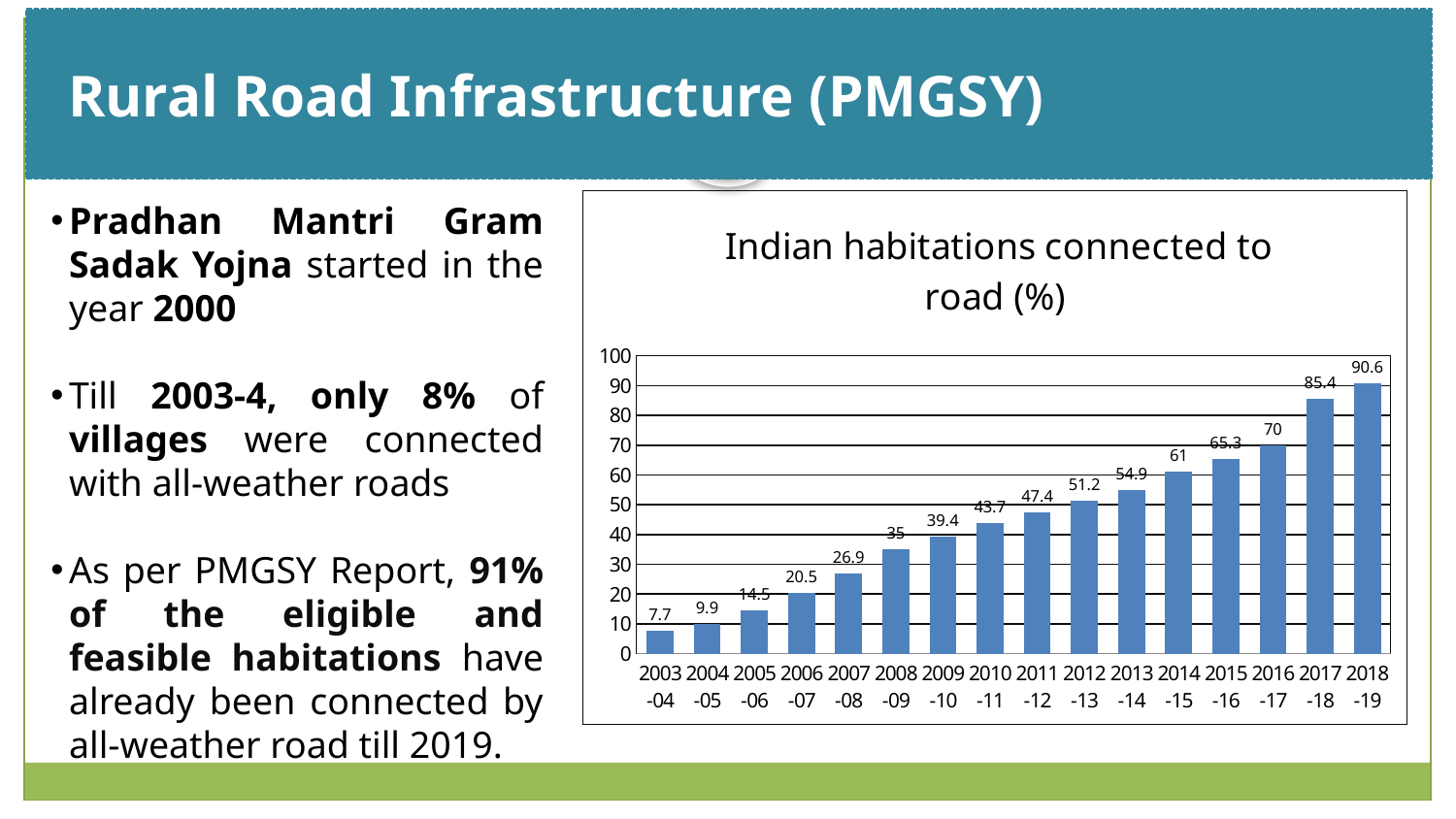
What is the value for 2003-04? 7.7 Which year has the highest value? 2018-19 What is the value for 2016-17? 70 What is the value for 2018-19? 90.6 What is the value for 2010-11? 43.7 How many years are shown on the x axis? 16 Which year has the lowest value? 2003-04 What type of chart is shown on the slide? bar chart Do the values rise or fall from 2003-04 to 2018-19? rise Which is larger, the value for 2012-13 or the value for 2014-15? 2014-15 What is the difference between the values for 2018-19 and 2003-04? 82.9 What is the title of the chart? Indian habitations connected to road (%)